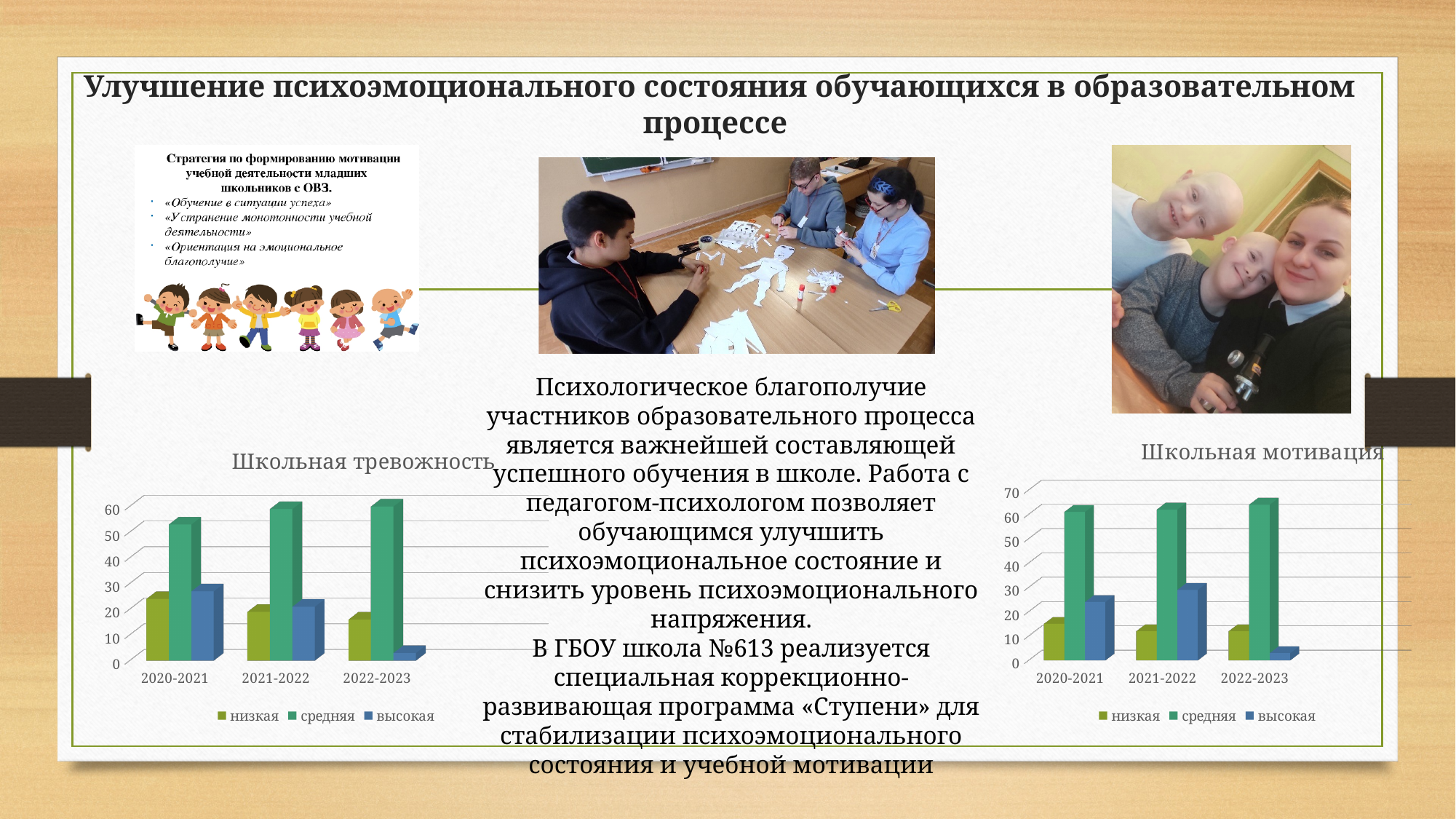
What is the title of the chart on the right side of the slide? Школьная мотивация In the "Школьная тревожность" chart, is the value for высокая in 2022-2023 greater or less than 10? less In the "Школьная мотивация" chart, which series has the lowest value in 2022-2023? высокая In the "Школьная тревожность" chart, is the value for средняя in 2021-2022 greater or less than 50? greater How many categories are shown on the x axis of the "Школьная мотивация" chart? 3 In the "Школьная тревожность" chart, do the values for низкая rise or fall from 2020-2021 to 2022-2023? fall In the "Школьная мотивация" chart, is the value for средняя in 2022-2023 greater or less than 60? greater What kind of chart is the "Школьная тревожность" chart? bar chart In the "Школьная тревожность" chart, which is larger for низкая: 2020-2021 or 2022-2023? 2020-2021 How many series does the legend of the "Школьная тревожность" chart list? 3 In the "Школьная тревожность" chart, which series has the highest value in 2020-2021? средняя